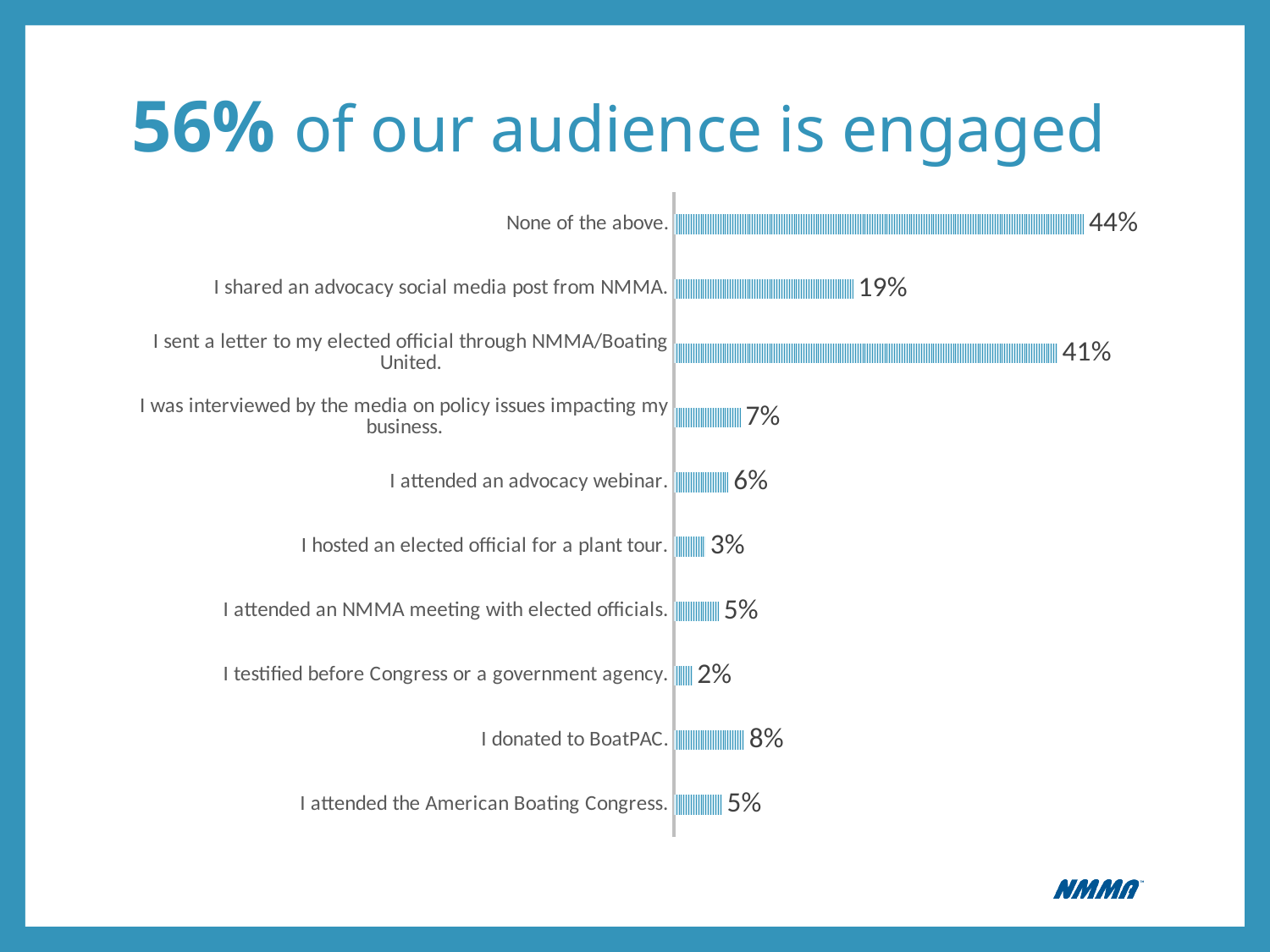
What is the difference between the percentage who sent a letter to their elected official and the percentage who shared an advocacy social media post? 22% Which category has the highest value in the chart? None of the above. How many categories are shown in the chart? 10 Which is larger: the percentage who attended an advocacy webinar or the percentage who donated to BoatPAC? I donated to BoatPAC. What percentage of respondents donated to BoatPAC? 8% What percentage of respondents selected "None of the above"? 44% What kind of chart is shown on the slide? Bar chart What is the title of the slide? 56% of our audience is engaged What percentage of respondents sent a letter to their elected official through NMMA/Boating United? 41% What percentage of respondents shared an advocacy social media post from NMMA? 19% What is the difference between the percentage who were interviewed by the media and the percentage who hosted an elected official for a plant tour? 4% Which category has the lowest value in the chart? I testified before Congress or a government agency.